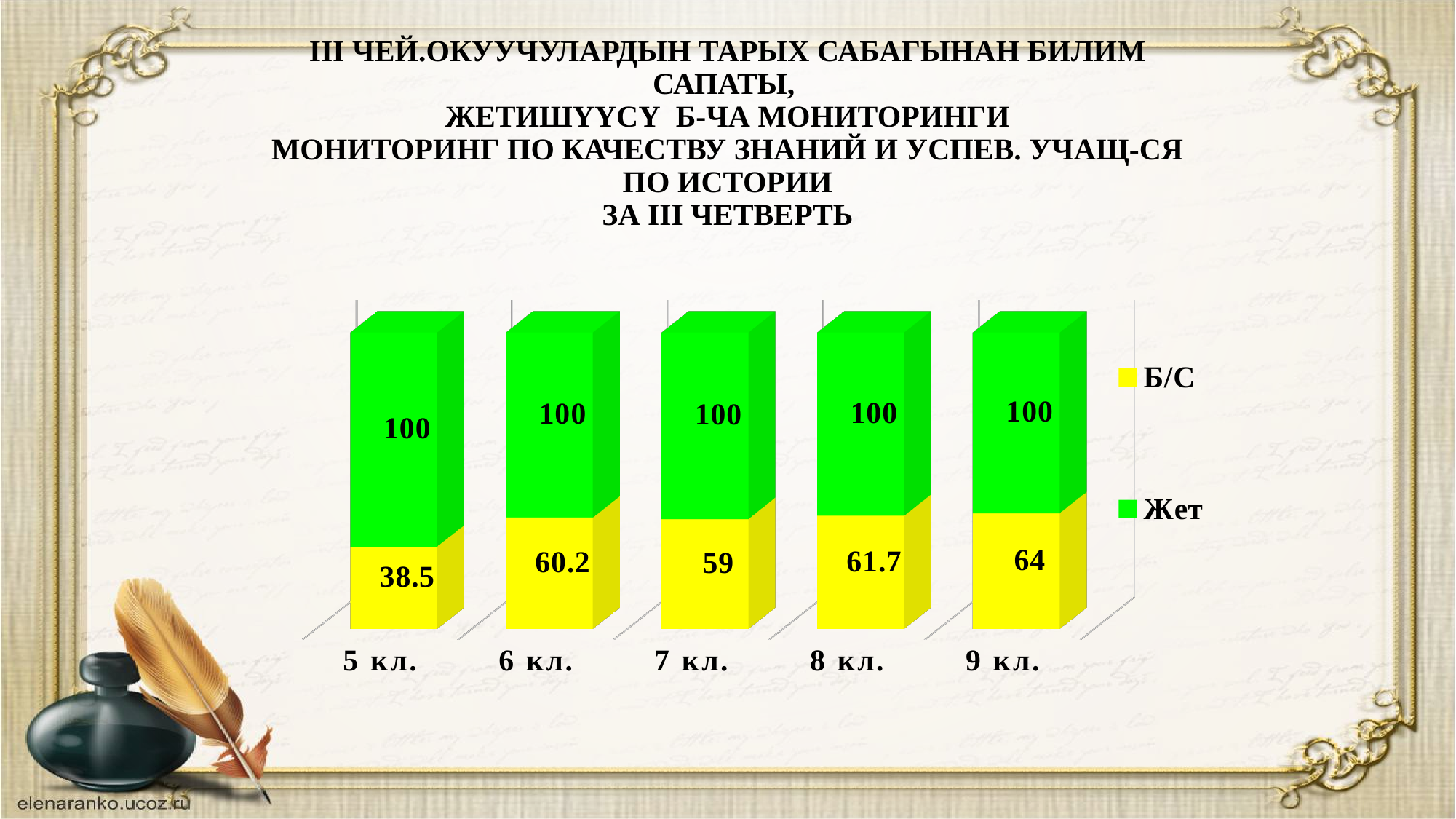
What is the total of the stacked bar for 6 кл.? 160.2 What is the difference between the Б/С values for 9 кл. and 5 кл.? 25.5 What is the Б/С value for 5 кл.? 38.5 Which colour represents the Жет series in the legend? Green How many series does the legend list? 2 Which class has the lowest Б/С value? 5 кл. What is the Жет value for 7 кл.? 100 Which has the larger Б/С value, 6 кл. or 7 кл.? 6 кл. What kind of chart is shown on the slide? Stacked bar chart How many classes are shown on the x axis? 5 What is the Б/С value for 8 кл.? 61.7 Which class has the highest Б/С value? 9 кл.